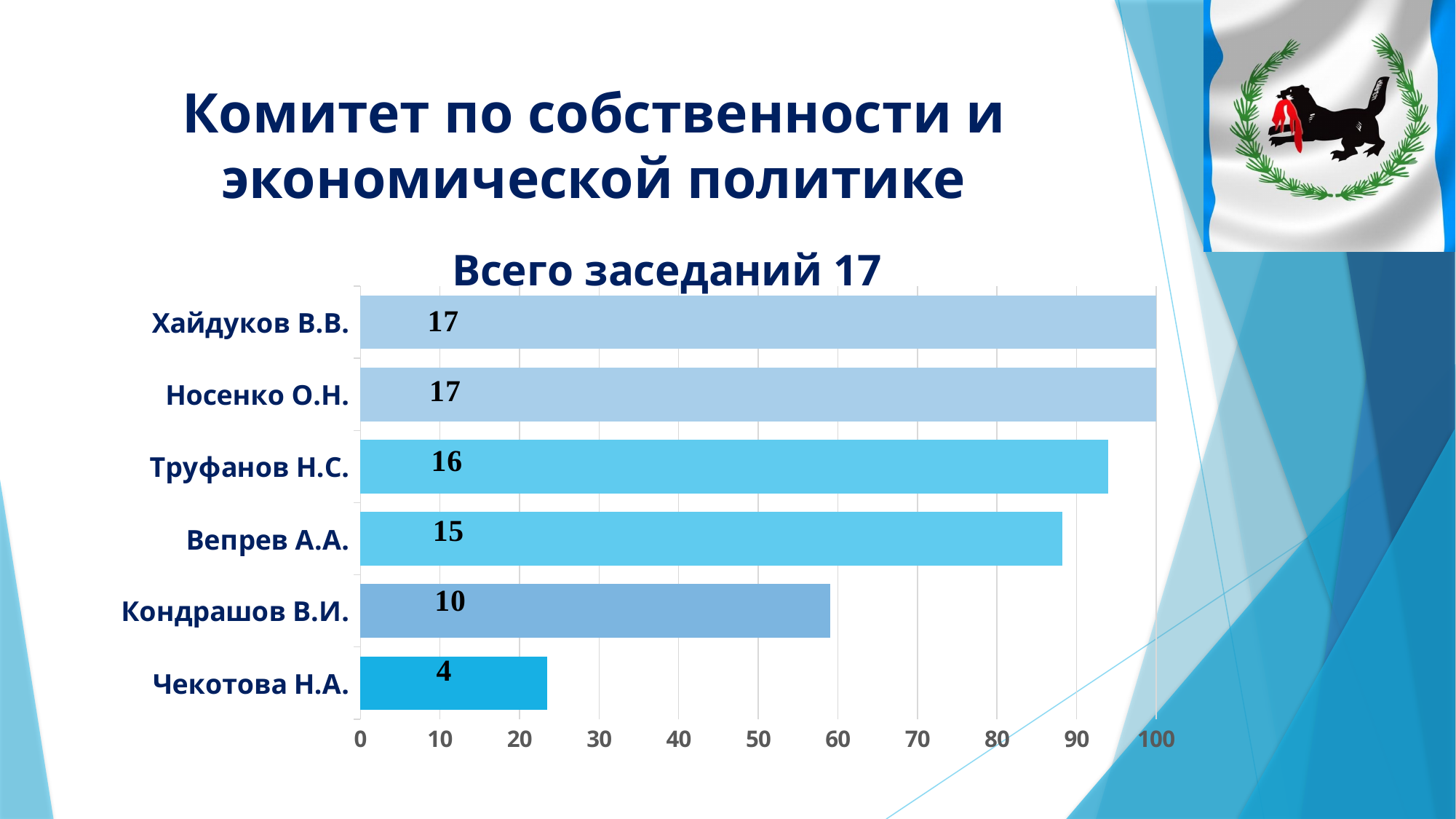
What is the data label shown for Вепрев А.А.? 15 What is the difference between the data labels for Хайдуков В.В. and Чекотова Н.А.? 13 What is the difference between the data labels for Труфанов Н.С. and Кондрашов В.И.? 6 What is the data label shown for Чекотова Н.А.? 4 On the horizontal axis, does the bar for Чекотова Н.А. extend greater or less than 30? less Which category has the lowest value in the chart? Чекотова Н.А. How many categories (people) are shown in the chart? 6 What is the data label shown for Кондрашов В.И.? 10 What type of chart is shown on the slide? bar chart Which has a larger value, Труфанов Н.С. or Кондрашов В.И.? Труфанов Н.С. What is the data label shown for Труфанов Н.С.? 16 On the horizontal axis, does the bar for Кондрашов В.И. extend greater or less than 50? greater